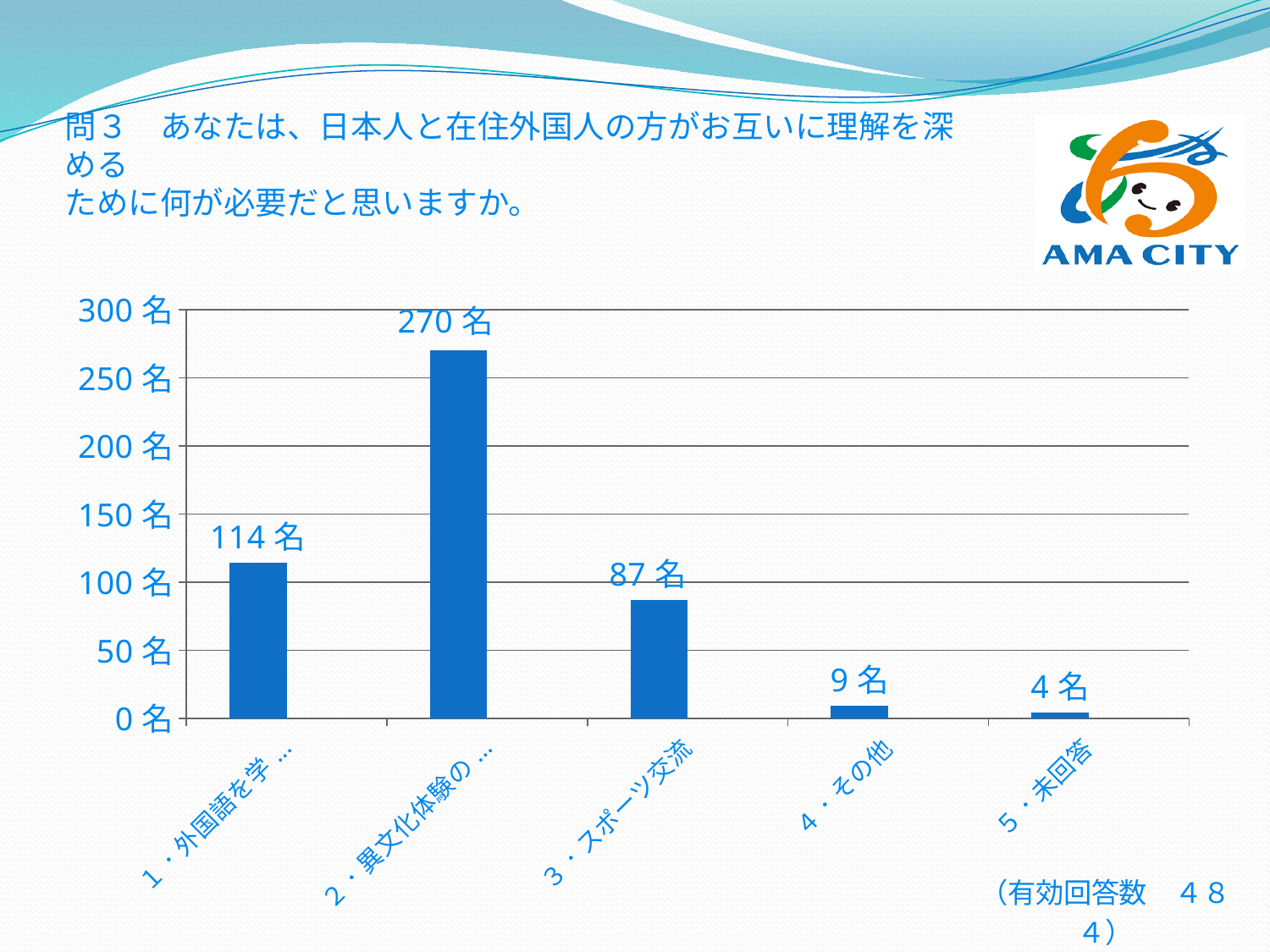
What is the value for 4・その他? 9名 What is the value for 5・未回答? 4名 What is the value of the first bar (1・外国語を学…)? 114名 What is the value of the second bar (2・異文化体験の…)? 270名 Which category has the lowest value? 5・未回答 Which category has the highest value? 2・異文化体験の… (the second category) What kind of chart is shown on the slide? Bar chart Which is larger, 3・スポーツ交流 or 4・その他? 3・スポーツ交流 What is the difference between 3・スポーツ交流 and 4・その他? 78名 How many categories are shown in the chart? 5 What is the value for 3・スポーツ交流? 87名 What is the difference between the second bar (2・異文化体験の…) and the first bar (1・外国語を学…)? 156名